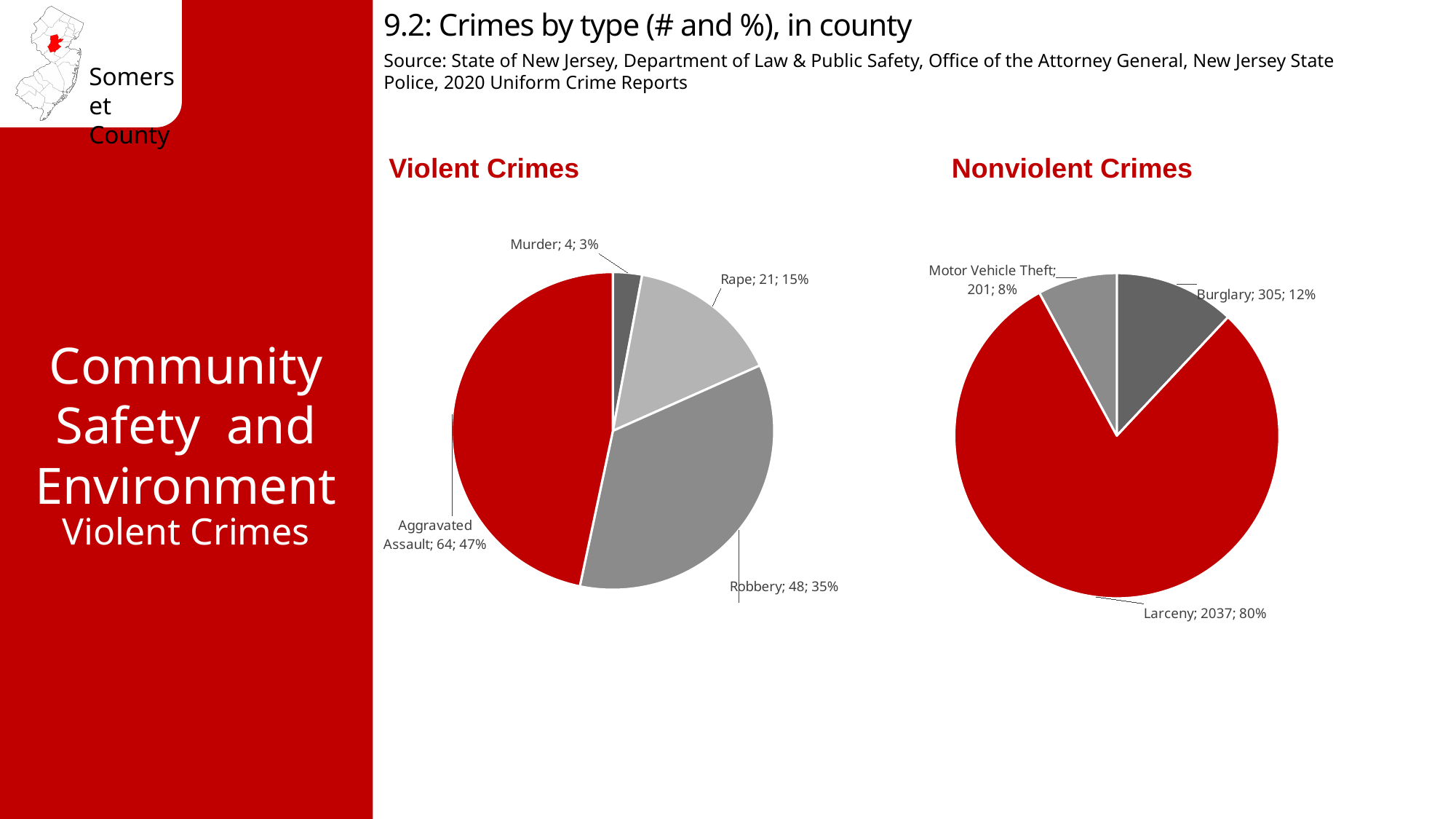
In the Violent Crimes chart, which category has the smallest slice? Murder In the Nonviolent Crimes chart, what colour is the Larceny slice? Red In the Nonviolent Crimes chart, what is the difference between the number of burglaries and the number of motor vehicle thefts? 104 In the Violent Crimes chart, how many categories are shown? 4 In the Violent Crimes chart, what percentage share does Robbery have? 35% In the Violent Crimes chart, which category has the largest slice? Aggravated Assault In the Violent Crimes chart, how many aggravated assaults are shown? 64 In the Nonviolent Crimes chart, which is larger, Burglary or Motor Vehicle Theft? Burglary In the Violent Crimes chart, what is the difference between the number of robberies and the number of rapes? 27 In the Nonviolent Crimes chart, what percentage share does Burglary have? 12% What type of chart is used for the Nonviolent Crimes data? Pie chart In the Nonviolent Crimes chart, how many larcenies are shown? 2037